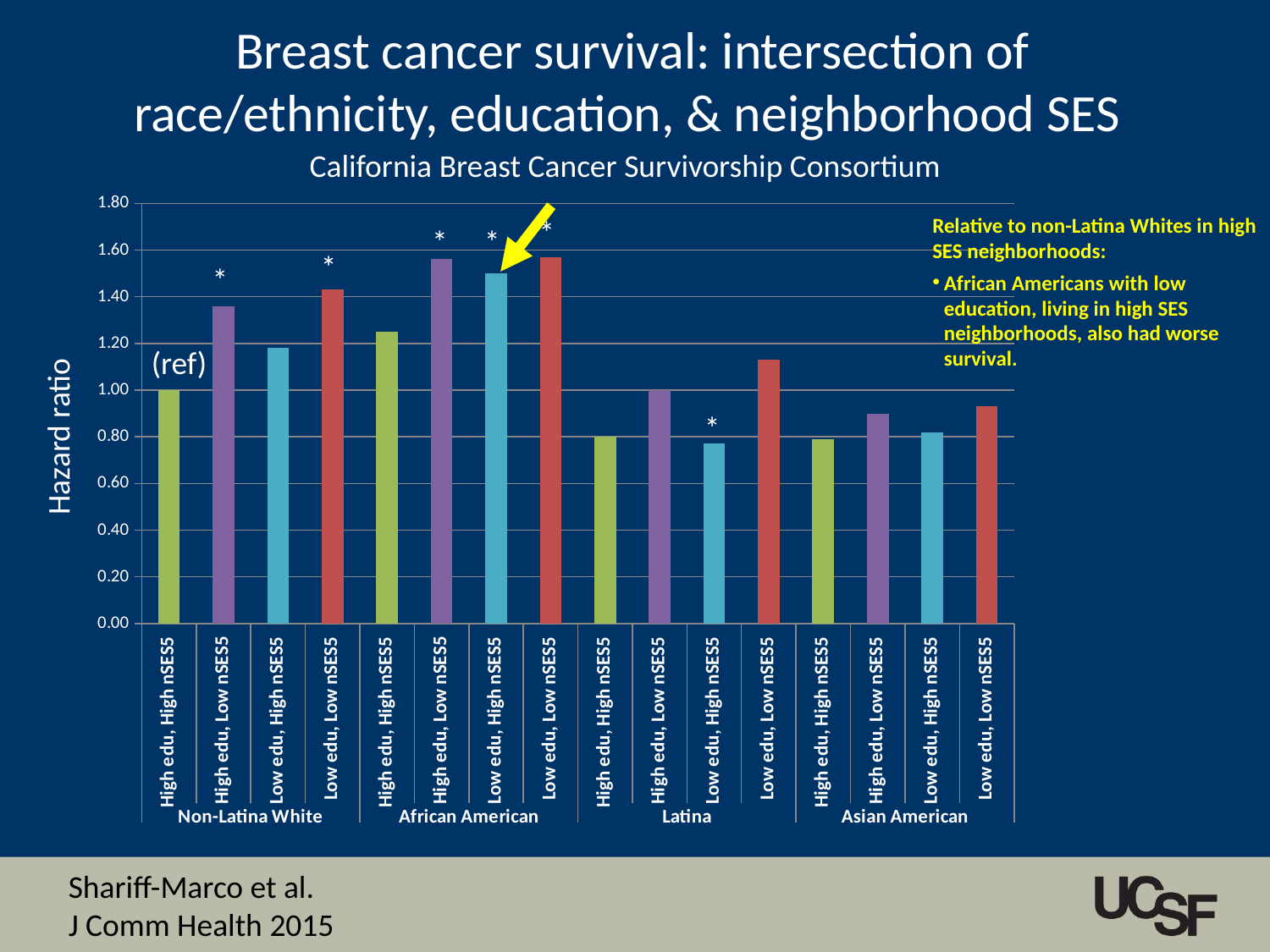
How many bars are plotted in the chart in total? 16 How many race/ethnicity groups are shown along the x axis? 4 Is the hazard ratio for Latina, Low edu, High nSES greater or less than 1.00? less What is the hazard ratio for the Non-Latina White, High edu, High nSES group (the reference bar)? 1.00 Is the hazard ratio for Asian American, Low edu, Low nSES greater or less than 1.00? less What type of chart is shown on the slide? Bar chart Is the hazard ratio for African American, Low edu, Low nSES greater or less than 1.40? greater Which bar is marked as the reference group (ref) in the chart? Non-Latina White, High edu, High nSES What is the label on the vertical axis of the chart? Hazard ratio Which has the larger hazard ratio: African American, Low edu, Low nSES or Asian American, Low edu, Low nSES? African American, Low edu, Low nSES Which has the larger hazard ratio: Non-Latina White, High edu, Low nSES or Latina, High edu, Low nSES? Non-Latina White, High edu, Low nSES